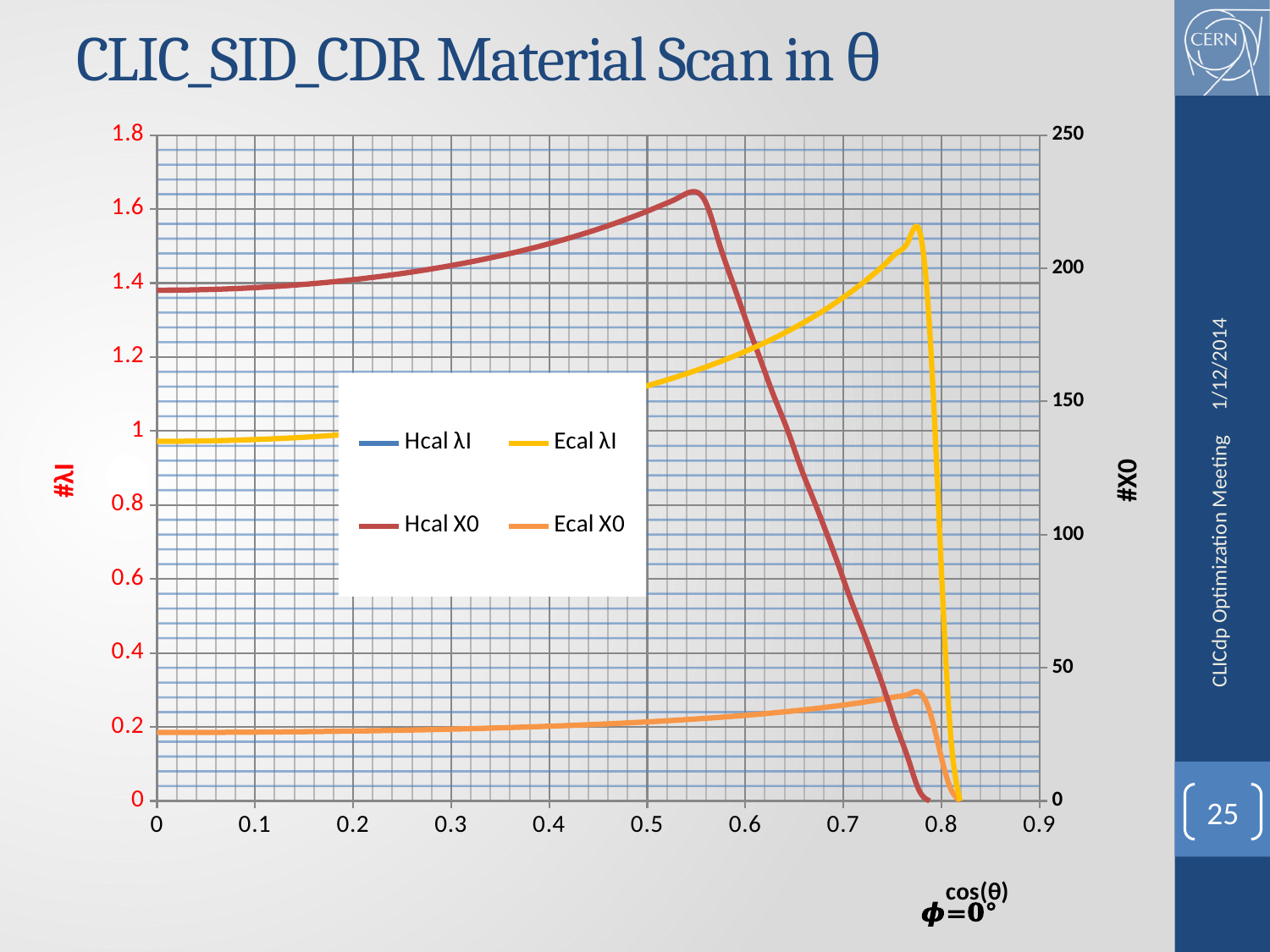
What kind of chart is shown on the slide? line chart What is the label of the right-hand vertical axis? #X0 What is the maximum value shown on the right vertical axis (#X0)? 250 Is the peak of the Hcal X0 curve greater or less than 200 on the #X0 axis? greater What is the title of the chart? CLIC_SID_CDR Material Scan in θ How many series does the legend list? 4 Is the Hcal X0 value at cos(θ) = 0 greater or less than 150 on the #X0 axis? greater Is the peak of the Ecal λI curve greater or less than 1.4 on the #λI axis? greater Does the Hcal X0 curve rise or fall between cos(θ) = 0.6 and cos(θ) = 0.8? fall What is the maximum value shown on the left vertical axis (#λI)? 1.8 Does the Ecal λI curve rise or fall between cos(θ) = 0.5 and cos(θ) = 0.75? rise